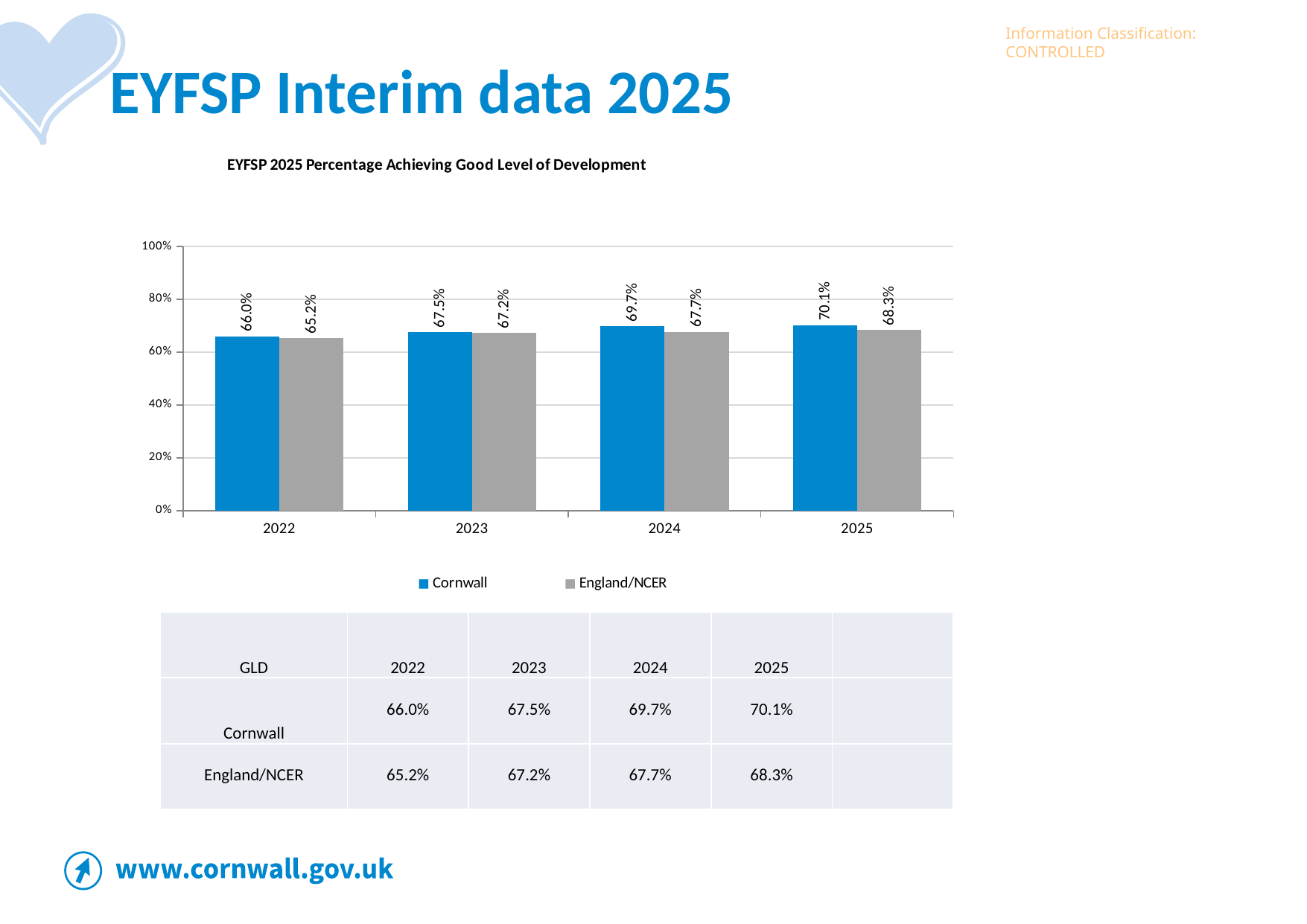
What is the England/NCER value for 2022? 65.2% What is the difference between the Cornwall values for 2025 and 2022? 4.1% What is the Cornwall value for 2025? 70.1% What is the difference between the Cornwall and England/NCER values in 2024? 2.0% Do the Cornwall values rise or fall from 2022 to 2025? Rise In which year is the Cornwall value highest? 2025 How many years are shown on the x axis? 4 What is the Cornwall value for 2024? 69.7% Which is larger in 2025, the Cornwall value or the England/NCER value? Cornwall What kind of chart is shown? Bar chart How many series does the legend list? 2 In which year is the England/NCER value lowest? 2022